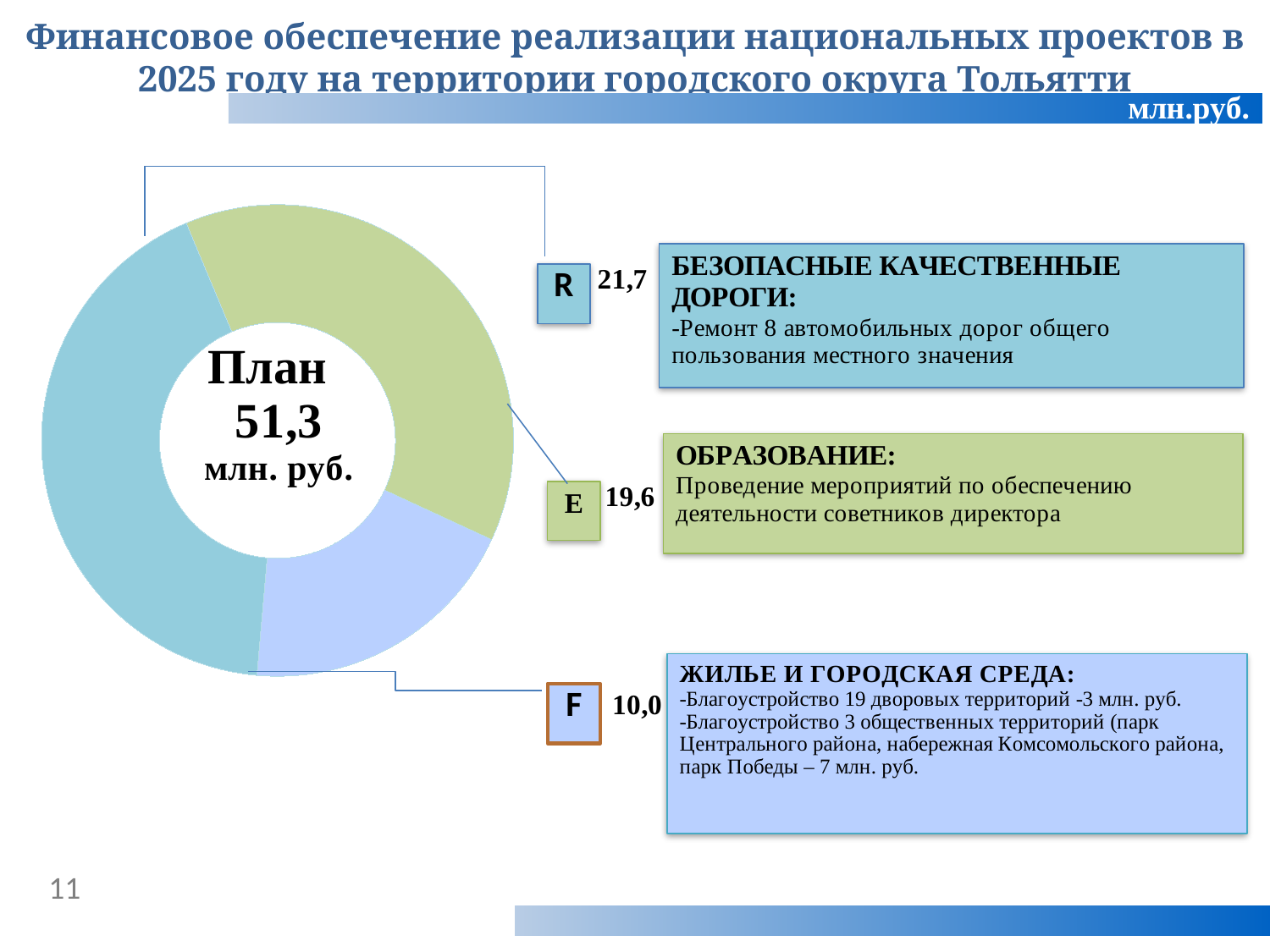
What is the value for segment R (Безопасные качественные дороги) in the donut chart? 21,7 What is the value for segment E (Образование) in the donut chart? 19,6 What total plan value is shown in the centre of the donut chart? 51,3 млн. руб. How many segments does the donut chart have? 3 What is the difference between the values for segment R and segment E? 2,1 What is the value for segment F (Жилье и городская среда) in the donut chart? 10,0 Which segment of the donut chart has the smallest value? F (Жилье и городская среда) Which segment of the donut chart has the largest value? R (Безопасные качественные дороги) In what units are the values on the chart given? млн.руб. What is the difference between the values for segment R and segment F? 11,7 What kind of chart is shown on the slide? pie chart (donut) Which is larger, the value for segment E or the value for segment F? E